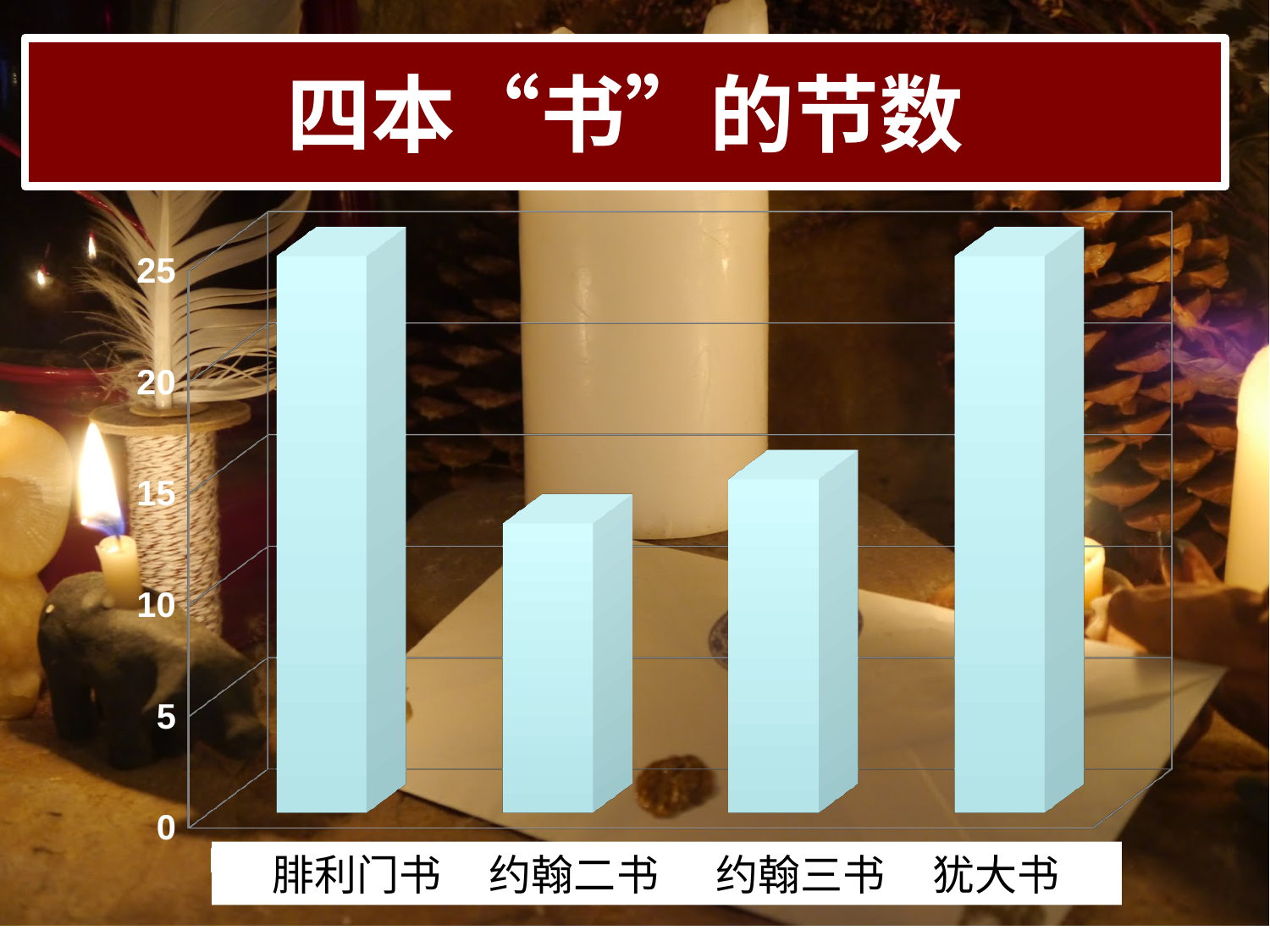
Is the value for 犹大书 greater or less than 20? greater Which is larger, the value for 腓利门书 or the value for 约翰三书? 腓利门书 What colour are the bars in the chart? light blue What kind of chart is shown on the slide? bar chart Is the value for 腓利门书 greater or less than 20? greater Which is larger, the value for 约翰三书 or the value for 约翰二书? 约翰三书 Is the value for 约翰二书 greater or less than 20? less How many categories (books) are shown on the x axis of the chart? 4 What is the title of the chart? 四本“书”的节数 Which book has the lowest bar in the chart? 约翰二书